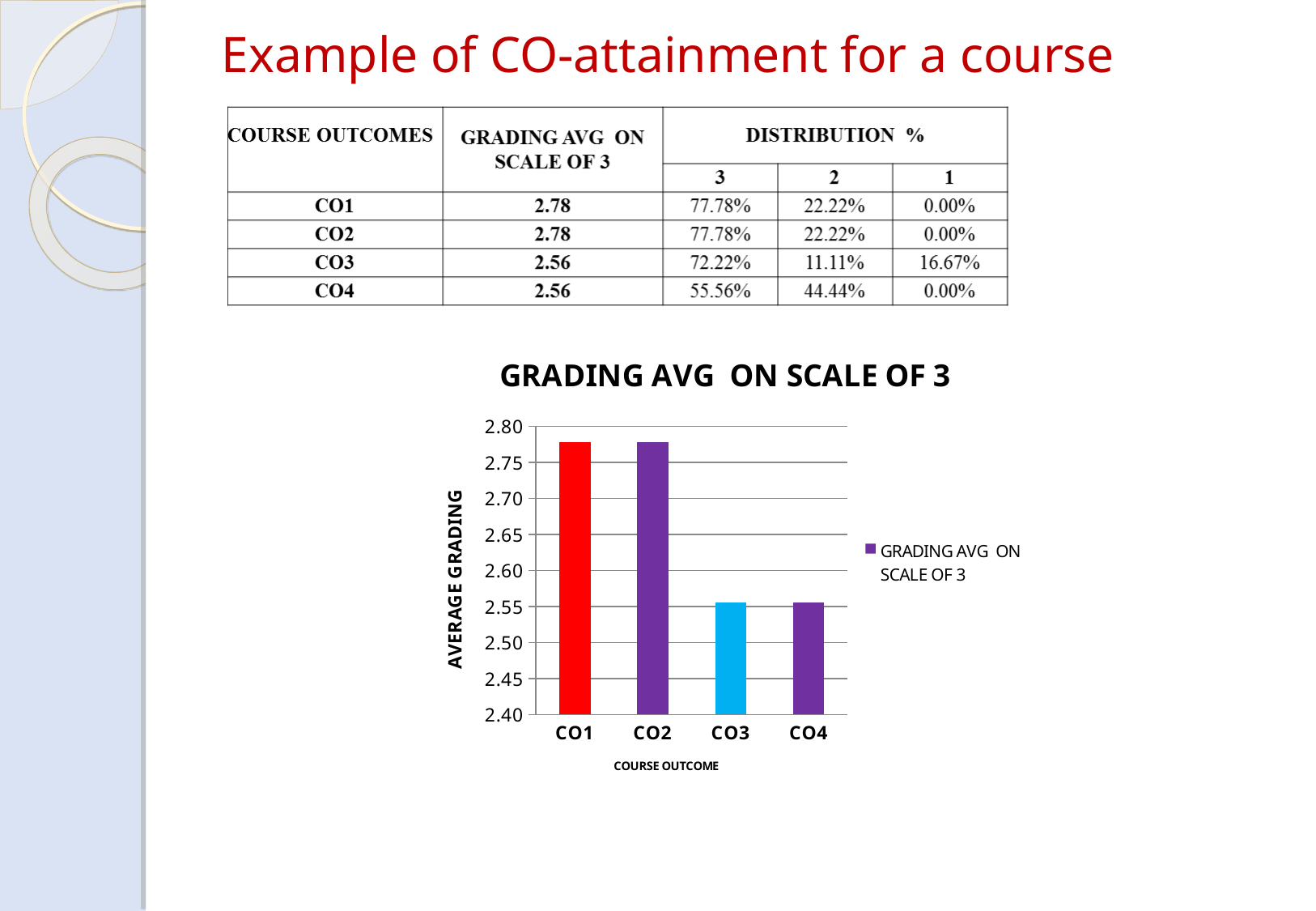
How many course outcomes are plotted on the x axis of the chart? 4 Which has the larger grading average, CO2 or CO3? CO2 Is the value for CO3 in the chart greater or less than 2.60? less What is the title of the chart? GRADING AVG ON SCALE OF 3 What is the label on the vertical axis of the chart? AVERAGE GRADING How many series does the chart legend list? 1 Do the grading averages generally rise or fall from CO1 to CO4? fall Is the value for CO4 in the chart greater or less than 2.50? greater Is the value for CO1 in the chart greater or less than 2.70? greater According to the slide, what is the grading average on scale of 3 for CO3? 2.56 What type of chart is shown on the slide? bar chart Which has the larger grading average, CO4 or CO1? CO1